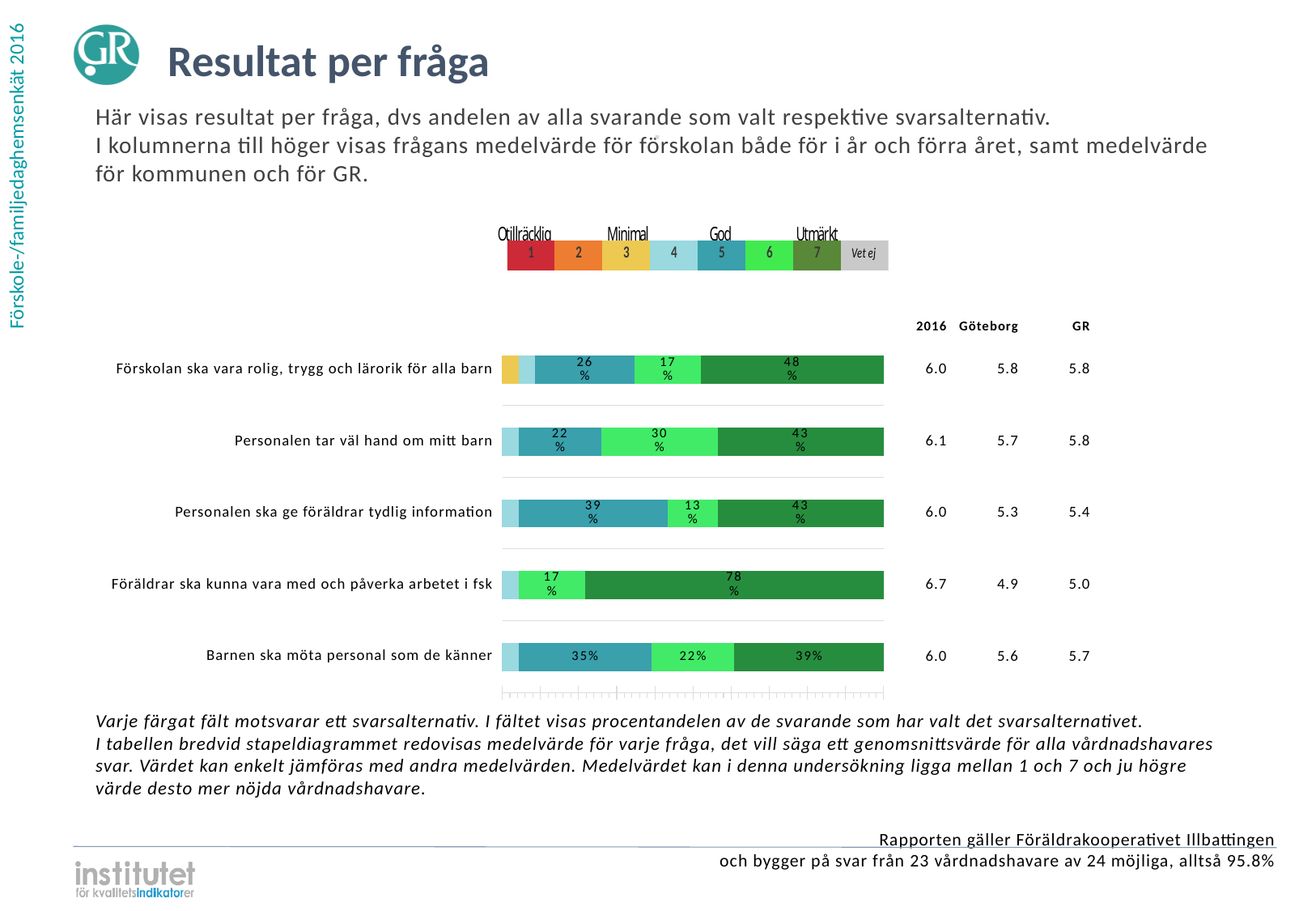
What percentage of respondents chose answer 7 (dark green) for "Föräldrar ska kunna vara med och påverka arbetet i fsk"? 78% How many questions (categories) are plotted in the bar chart? 5 What kind of chart is shown on the slide? Stacked bar chart What is the Göteborg mean value shown for "Personalen ska ge föräldrar tydlig information"? 5.3 What is the 2016 mean value shown for "Föräldrar ska kunna vara med och påverka arbetet i fsk"? 6.7 What percentage of respondents chose answer 6 (light green) for "Personalen tar väl hand om mitt barn"? 30% Which question has the smallest share of respondents choosing answer 6 (light green)? Personalen ska ge föräldrar tydlig information What percentage of respondents chose answer 7 (dark green) for "Barnen ska möta personal som de känner"? 39% What percentage of respondents chose answer 5 (teal) for "Personalen ska ge föräldrar tydlig information"? 39% Which question has the largest share of respondents choosing answer 7 (dark green)? Föräldrar ska kunna vara med och påverka arbetet i fsk Which is larger: the answer 5 share for "Personalen ska ge föräldrar tydlig information" or for "Barnen ska möta personal som de känner"? Personalen ska ge föräldrar tydlig information What is the difference between the answer 7 share for "Förskolan ska vara rolig, trygg och lärorik för alla barn" (48%) and for "Barnen ska möta personal som de känner" (39%)? 9 percentage points